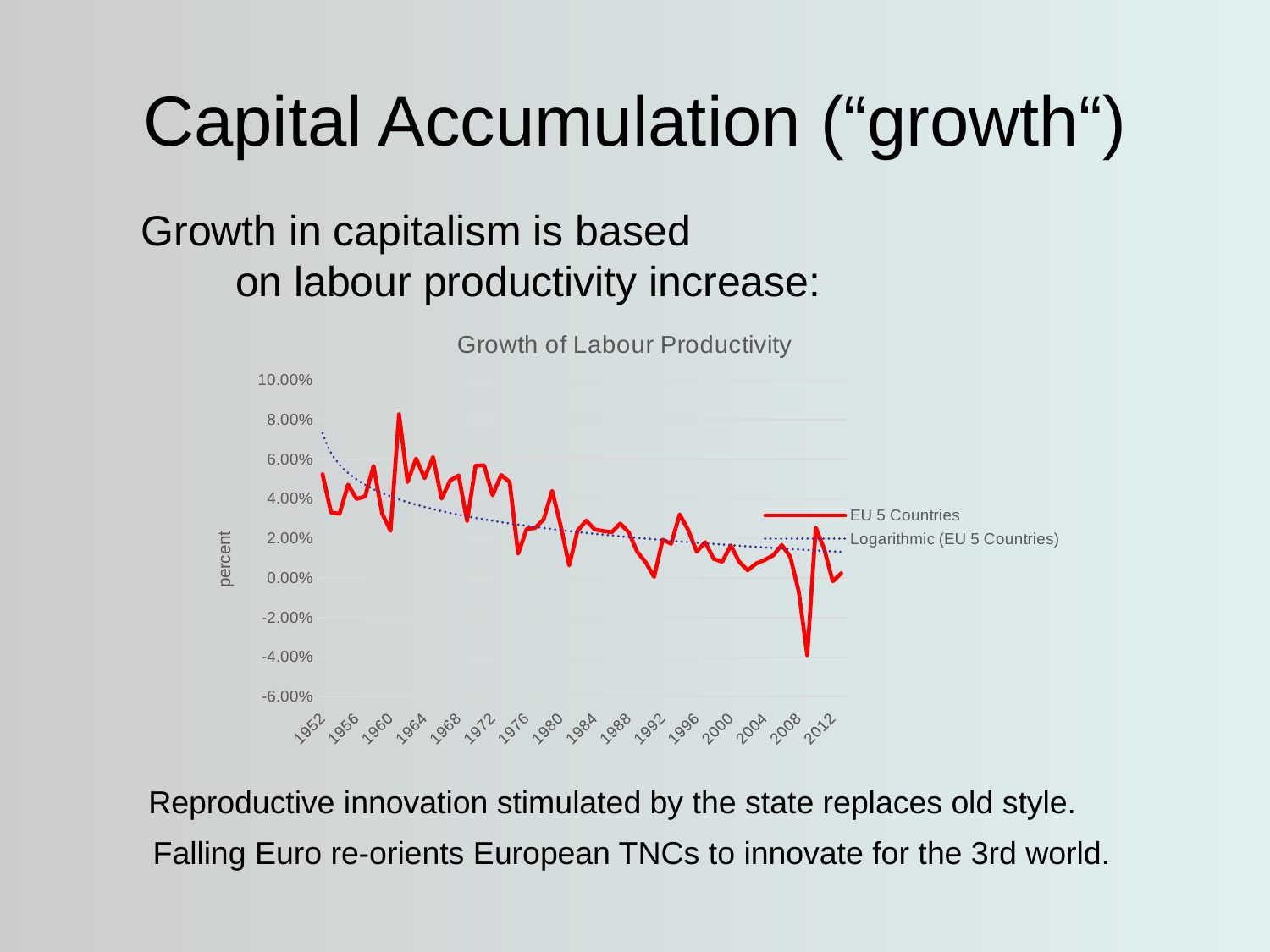
Is the value for EU 5 Countries in 1952 greater or less than 4.00%? greater How many year labels are shown on the x axis? 16 What label is shown on the vertical axis of the chart? percent Is the highest point of the EU 5 Countries line greater or less than 6.00%? greater Overall, does the EU 5 Countries line rise or fall from 1952 to 2012? fall Is the value for EU 5 Countries in 2012 greater or less than 2.00%? less Which is larger for EU 5 Countries, the value in 1952 or the value in 2012? 1952 How many series does the chart legend list? 2 What kind of chart is shown on the slide? line chart What is the title of the chart? Growth of Labour Productivity